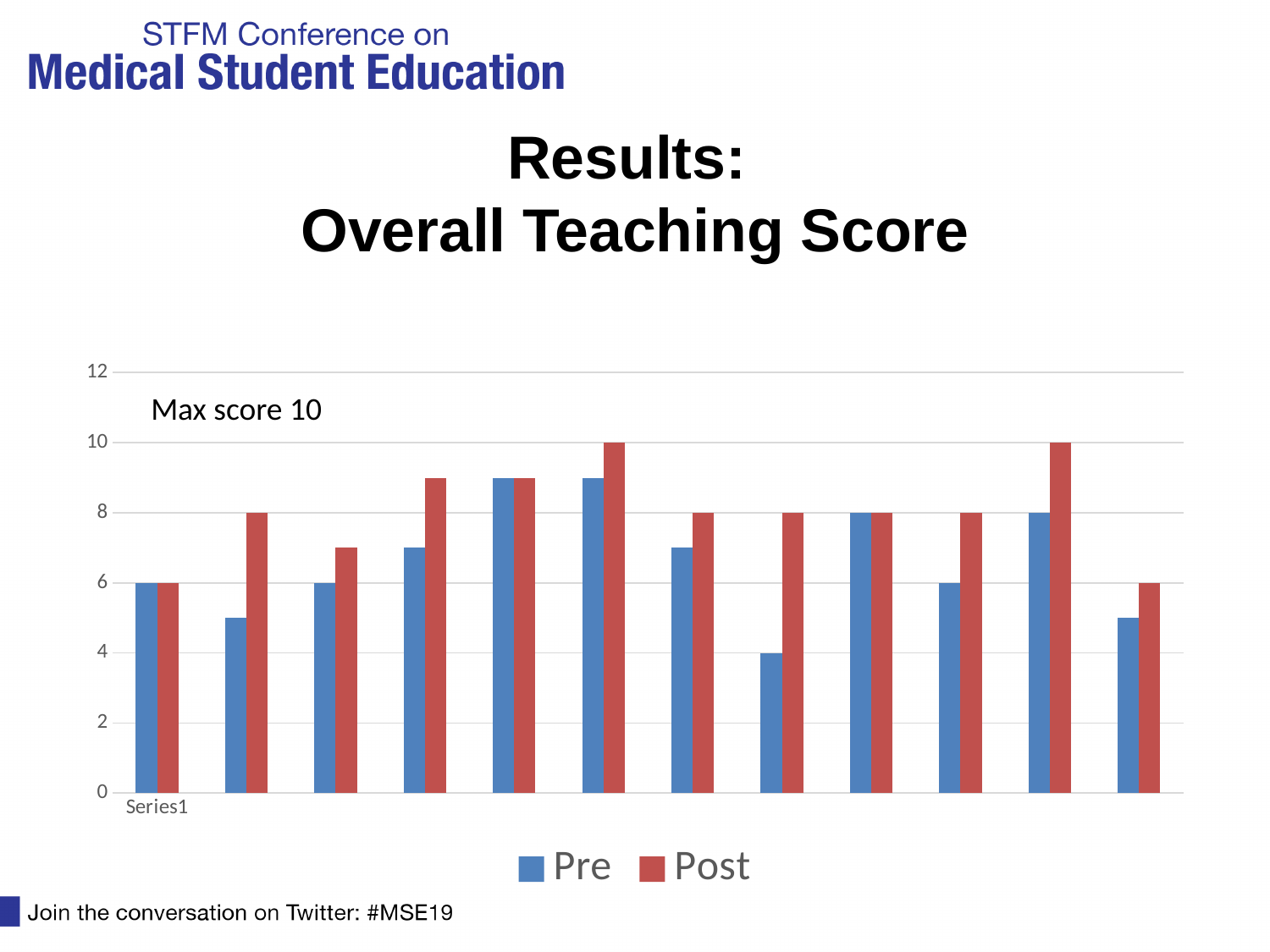
How many groups of bars are plotted in the chart? 12 What is the Pre value for Series1? 6 What kind of chart is shown on the slide? bar chart What is the highest Post value plotted in the chart? 10 What are the two series named in the legend? Pre and Post What is the highest value shown on the vertical axis? 12 What maximum score does the annotation on the chart state? Max score 10 What is the lowest Pre value plotted in the chart? 4 Is the Pre value for Series1 greater or less than 8? less What is the Post value for Series1? 6 How many series does the legend list? 2